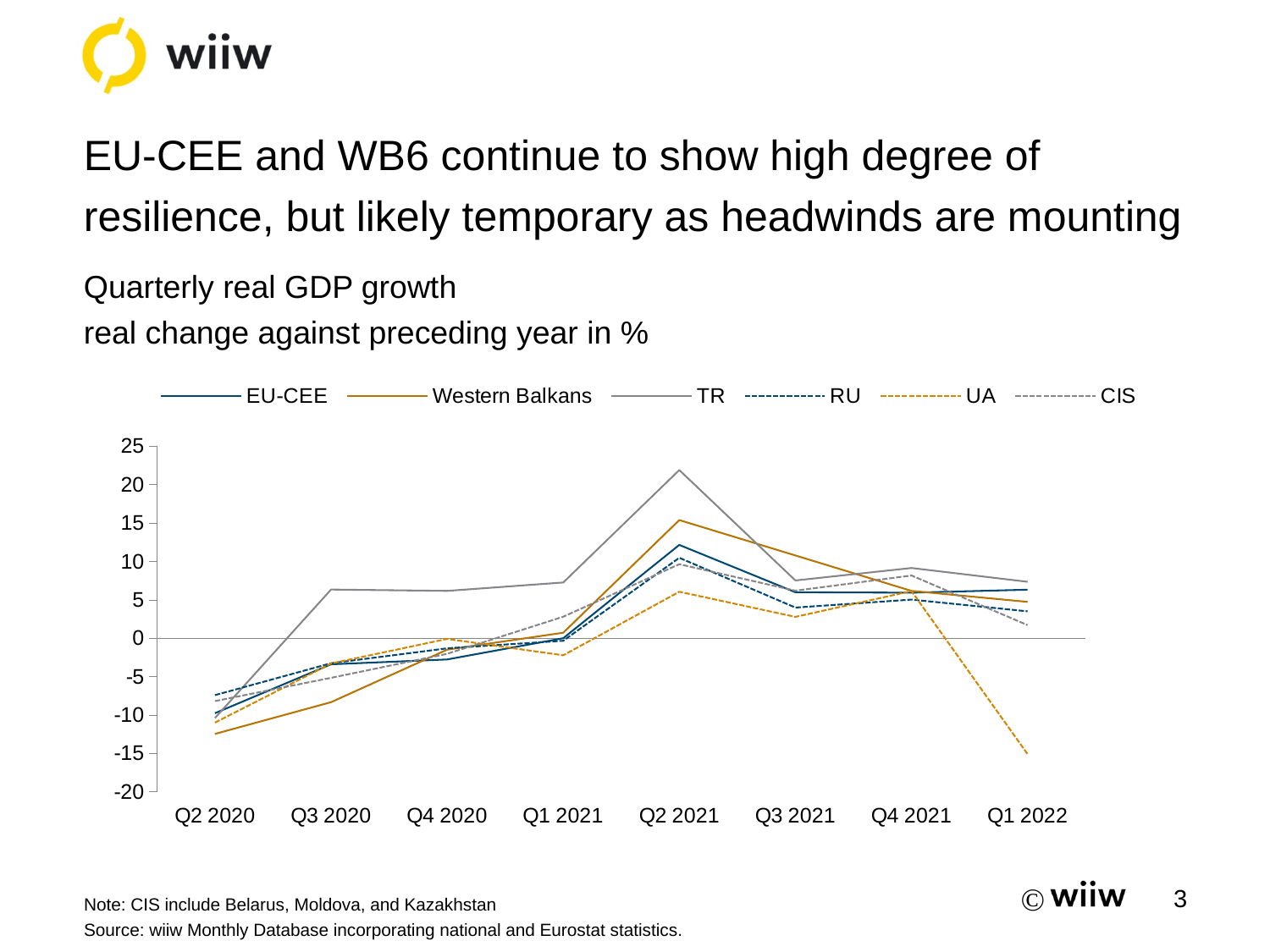
Is the value for UA in Q1 2022 greater or less than -10? less What kind of chart is shown on the slide? line chart In Q2 2020, which is larger: the value for RU or the value for Western Balkans? RU Which series has the highest value in Q2 2021? TR Is the value for TR in Q2 2021 greater or less than 20? greater Which series has the lowest value in Q1 2022? UA How many series does the legend list? 6 Is the value for EU-CEE in Q2 2021 greater or less than 10? greater How many quarters are shown on the x axis? 8 What is the title of the chart? Quarterly real GDP growth Does the UA line rise or fall from Q4 2021 to Q1 2022? fall Which series has the lowest value in Q2 2020? Western Balkans